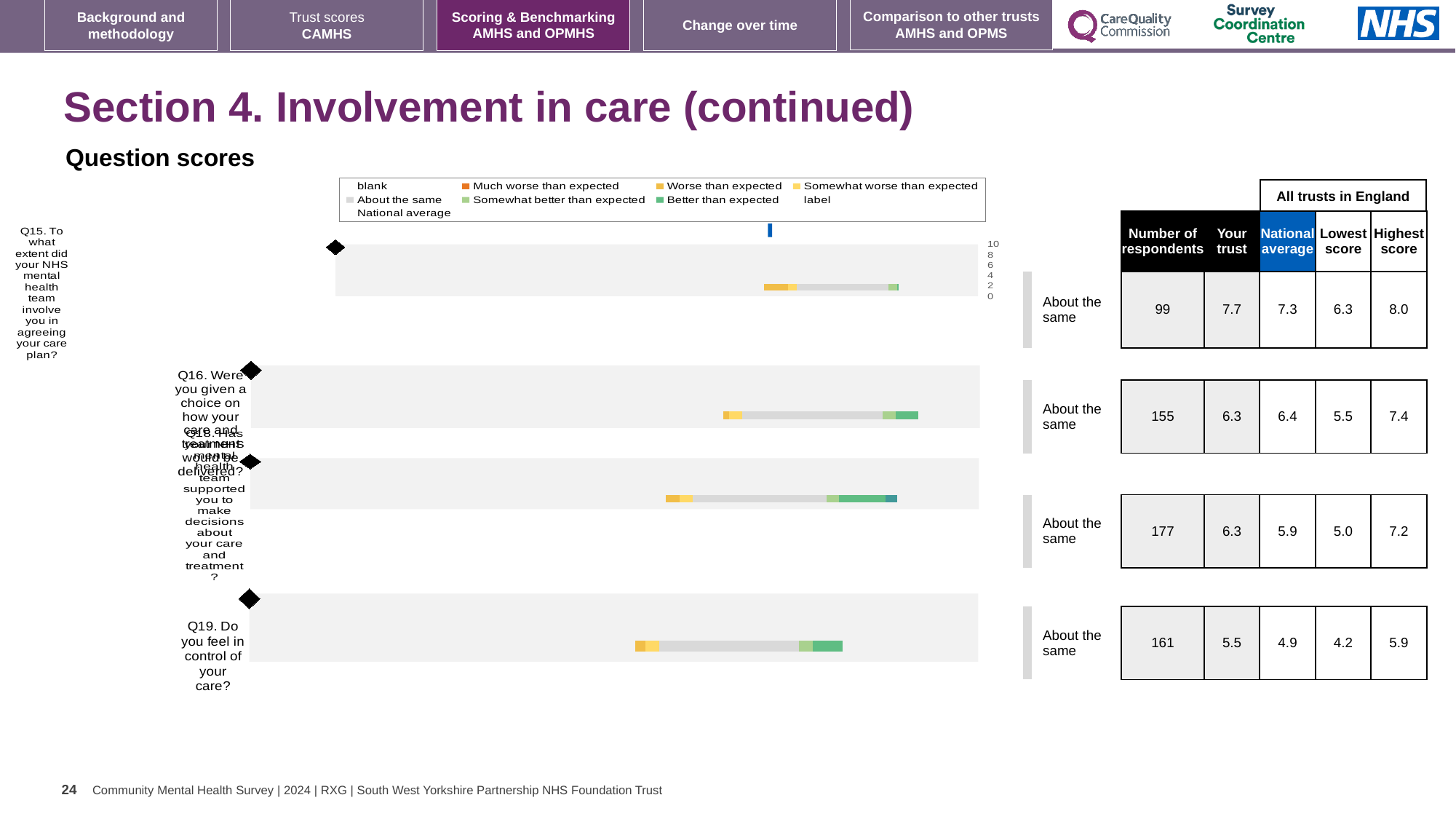
Which question has the lowest 'Your trust' score? Q19 Which question has the highest 'Your trust' score? Q15 How many questions (categories) are plotted in the question scores chart? 4 What is the difference between the 'Your trust' score and the national average for Q15? 0.4 How many respondents answered Q18 (supported to make decisions about care and treatment)? 177 For Q16, which is larger: the 'Your trust' score or the national average? National average What is the lowest score among all trusts in England for Q18? 5.0 What benchmark category is shown for Q19? About the same What is the national average score for Q19 (feeling in control of your care)? 4.9 What kind of chart is used to show the question scores on this slide? bar chart What is the highest score among all trusts in England for Q16 (choice on how care and treatment would be delivered)? 7.4 What is the 'Your trust' score for Q15 (involving you in agreeing your care plan)? 7.7